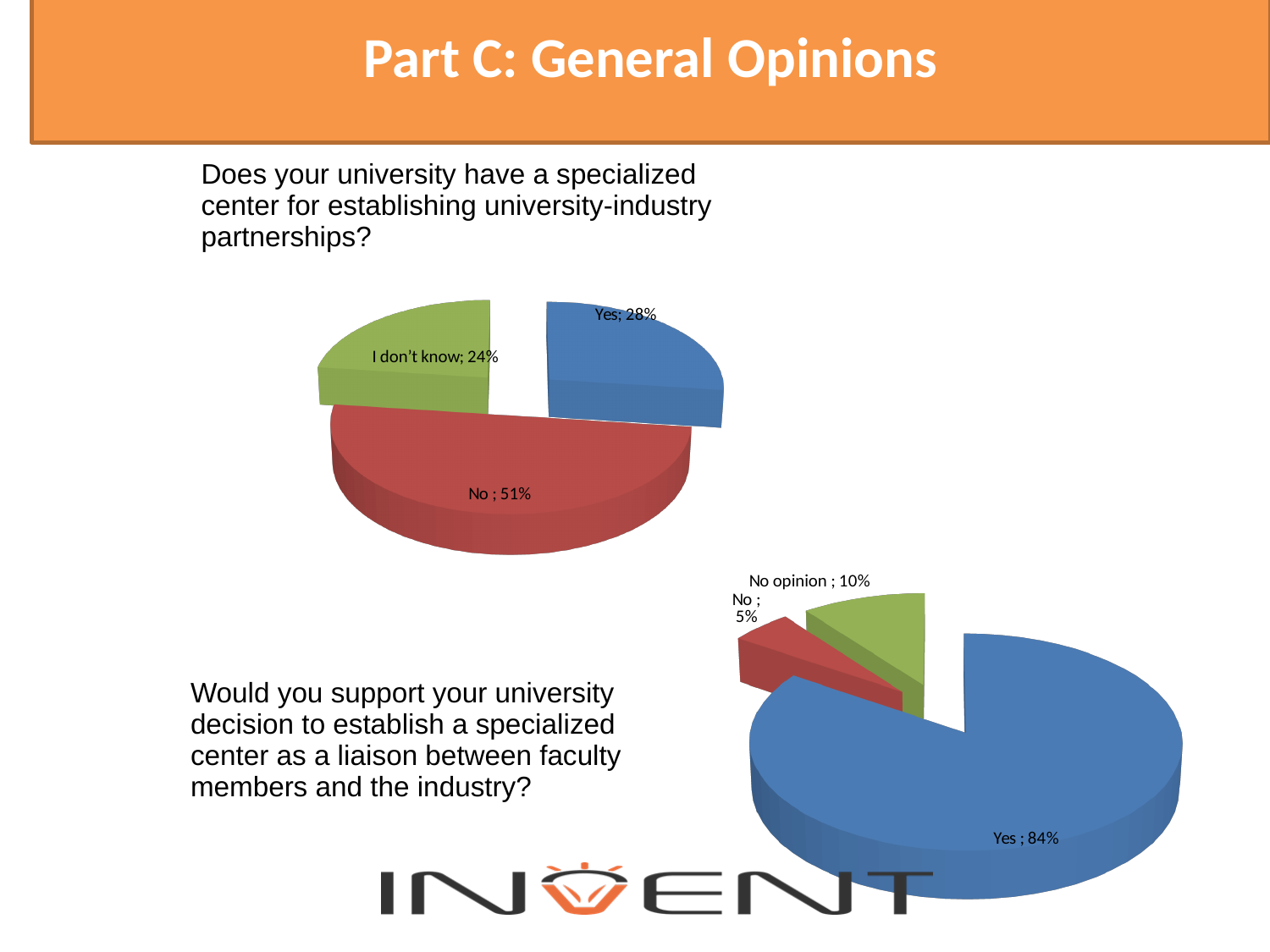
In the upper pie chart about whether the university has a specialized center for university-industry partnerships, what percentage answered "No"? 51% In the lower pie chart about supporting a specialized liaison center, what percentage answered "Yes"? 84% In the upper pie chart about whether the university has a specialized center, what percentage answered "I don't know"? 24% In the upper pie chart about whether the university has a specialized center, how many percentage points larger is "No" than "Yes"? 23 In the lower pie chart about supporting a specialized liaison center, what percentage answered "No"? 5% In the upper pie chart about whether the university has a specialized center, what percentage answered "Yes"? 28% In the upper pie chart about whether the university has a specialized center, which response has the largest share? No In the upper pie chart about whether the university has a specialized center, which response has the smallest share? I don't know In the lower pie chart about supporting a specialized liaison center, what percentage answered "No opinion"? 10% How many slices does the lower pie chart about supporting a specialized liaison center have? 3 In the lower pie chart about supporting a specialized liaison center, which is larger: "No" or "No opinion"? No opinion What type of chart is used for the question about whether the university has a specialized center? Pie chart